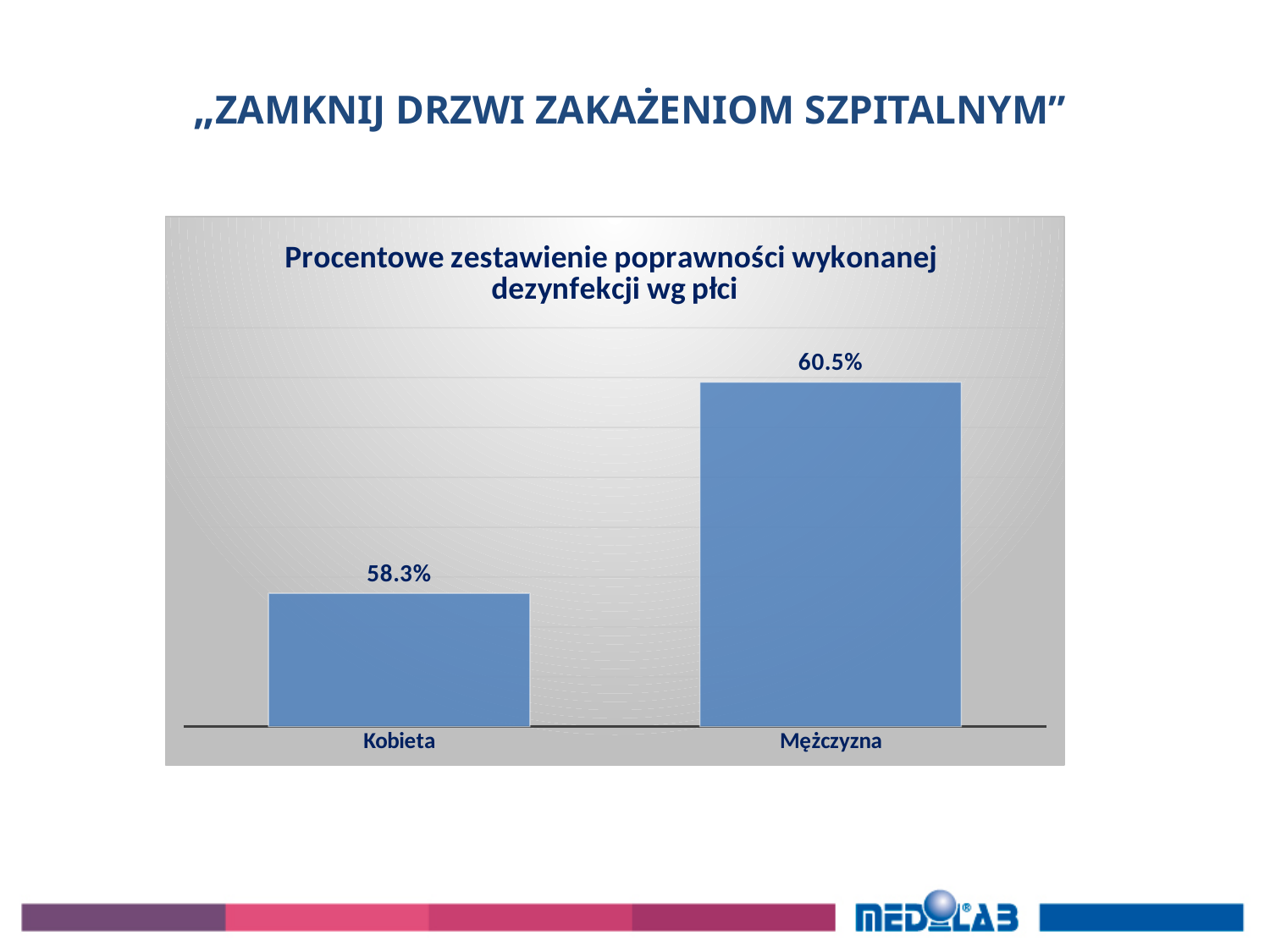
What colour are the bars in the chart? blue What is the difference between the values for Mężczyzna and Kobieta? 2.2% What is the value for Kobieta? 58.3% Which category has the lowest value? Kobieta What kind of chart is shown on the slide? bar chart Which is larger, the value for Kobieta or the value for Mężczyzna? Mężczyzna What is the title of the chart? Procentowe zestawienie poprawności wykonanej dezynfekcji wg płci What is the value for Mężczyzna? 60.5% How many categories are shown in the chart? 2 Which category has the highest value? Mężczyzna